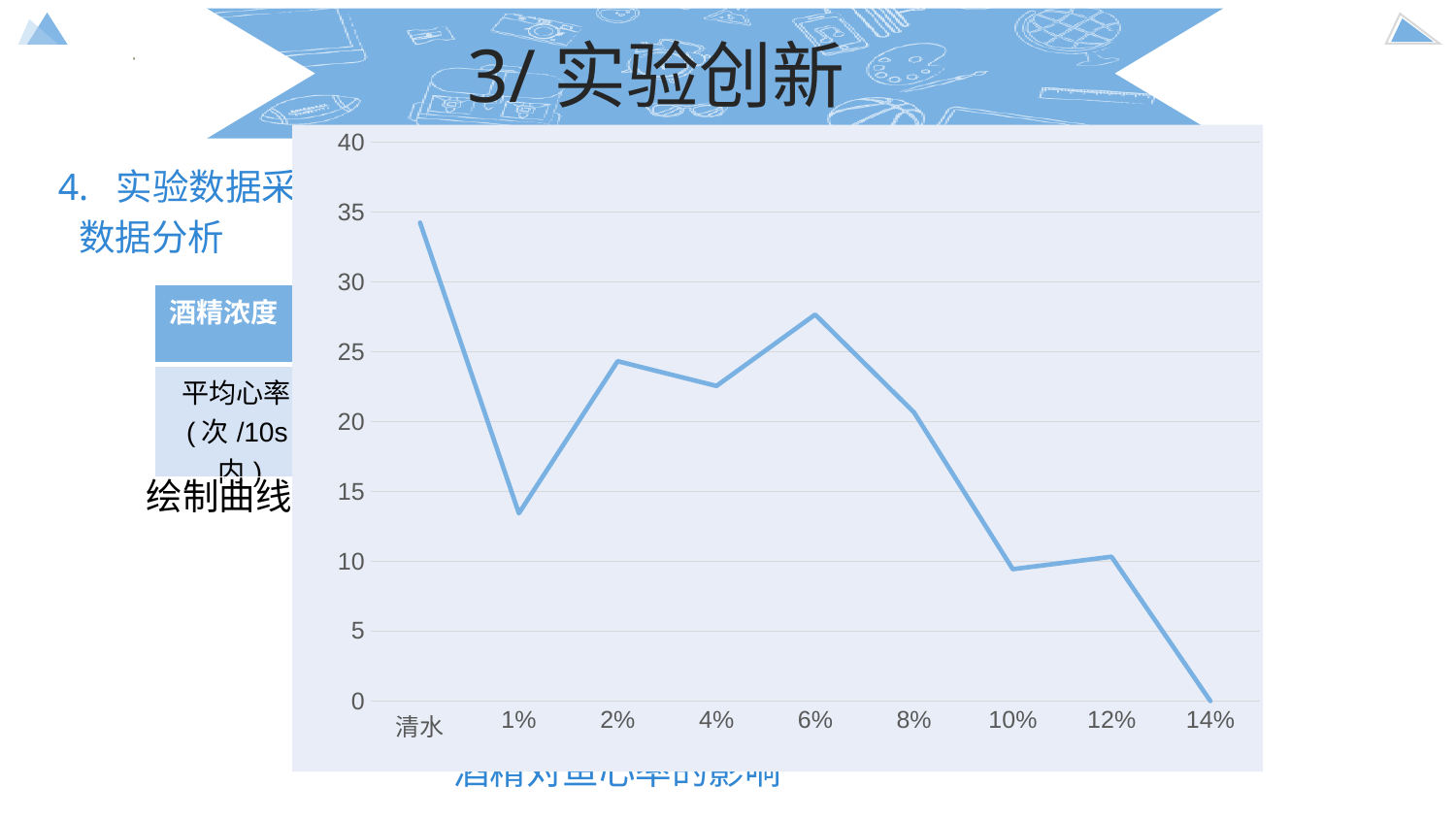
Which is larger, the value for 6% or the value for 8%? 6% How many categories are plotted along the x axis of the chart? 9 What kind of chart is shown on the slide? line chart What is the value for 14% in the chart? 0 Overall, do the values rise or fall from 清水 to 14% along the x axis? fall Which category has the lowest value in the chart? 14% Is the value for 清水 greater or less than 30? greater Is the value for 1% greater or less than 15? less Which category has the highest value in the chart? 清水 Which is larger, the value for 清水 or the value for 1%? 清水 Is the value for 6% greater or less than 25? greater